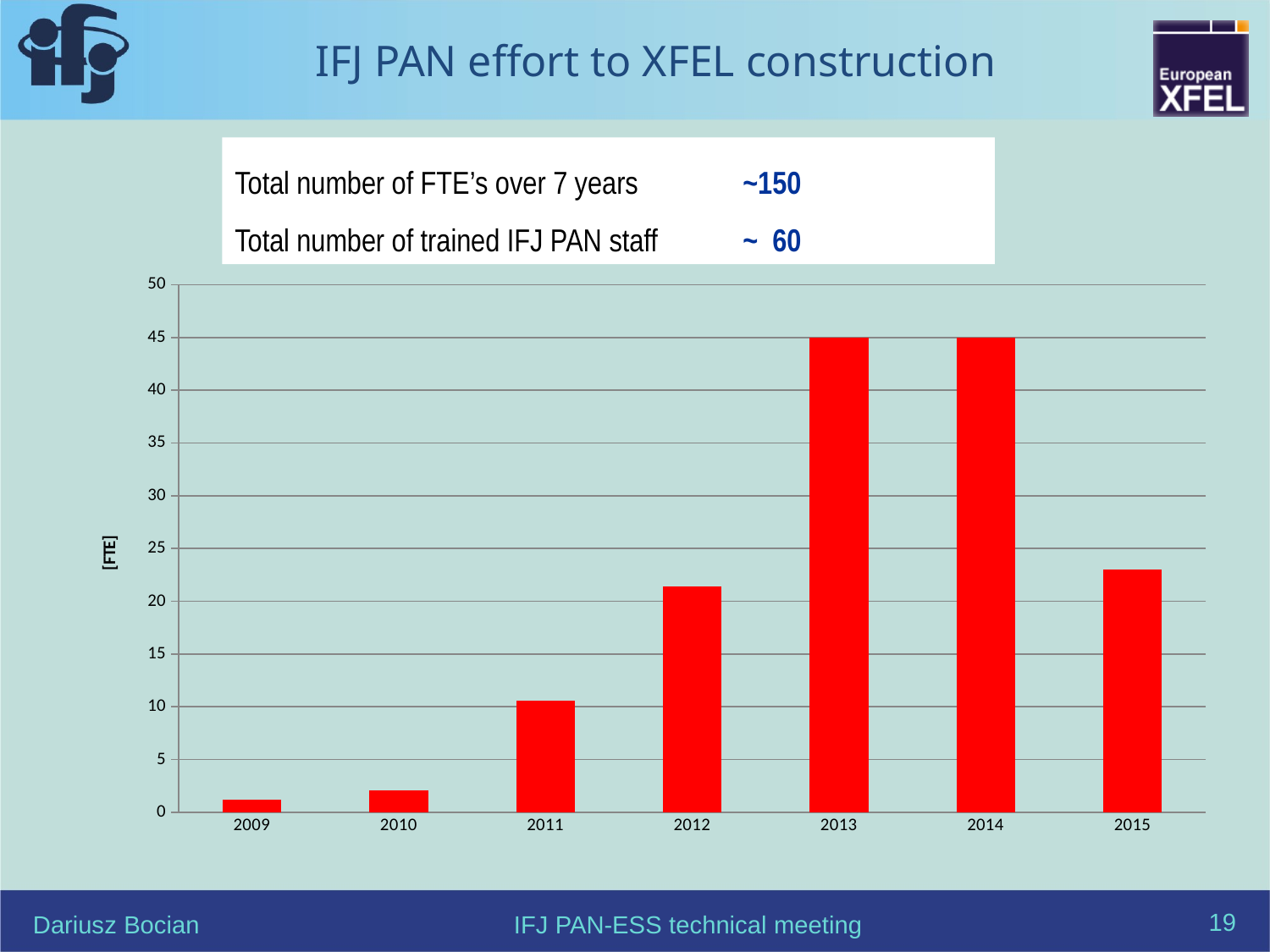
What is the value for 2014 in the chart? 45 How many years are shown on the x axis of the chart? 7 Which is larger, the value for 2011 or the value for 2012? 2012 What is the label on the y axis of the chart? [FTE] Which year has the lowest value in the chart? 2009 Is the value for 2015 greater or less than 25? less Do the values rise or fall from 2009 to 2013? rise Is the value for 2010 greater or less than 5? less Is the value for 2011 greater or less than 15? less What is the value for 2013 in the chart? 45 What kind of chart is shown on the slide? bar chart